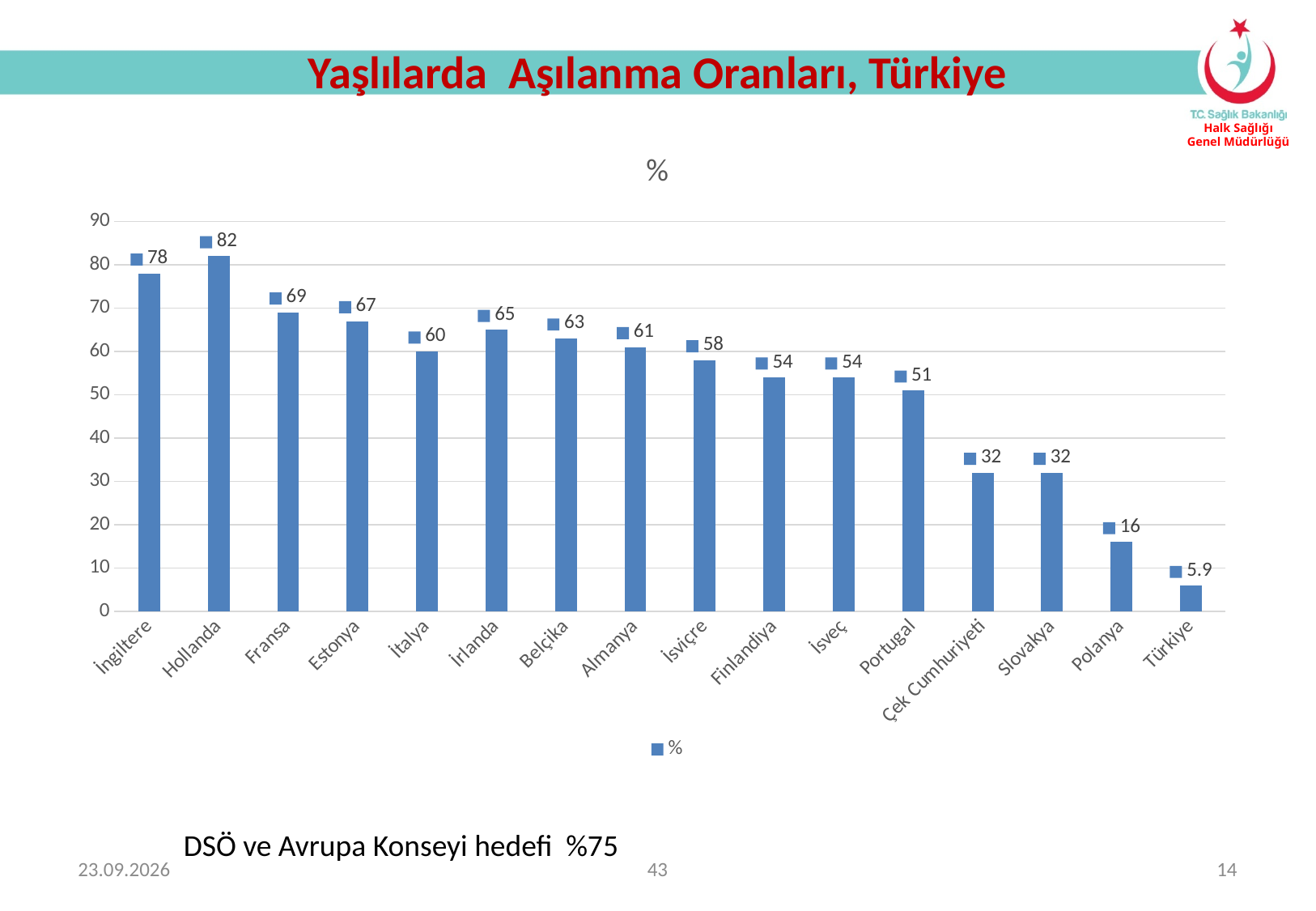
What is the value for Türkiye? 5.9 What is the value for Hollanda? 82 Is the value for Polonya greater or less than 20? less How many series does the legend list? 1 Which country has the lowest value? Türkiye How many countries are shown on the chart? 16 What kind of chart is shown on the slide? bar chart What is the title of the chart? % What is the value for Belçika? 63 Which country has the highest value? Hollanda Which is larger, the value for Estonya or the value for İrlanda? Estonya What is the difference between the values for İngiltere and Fransa? 9